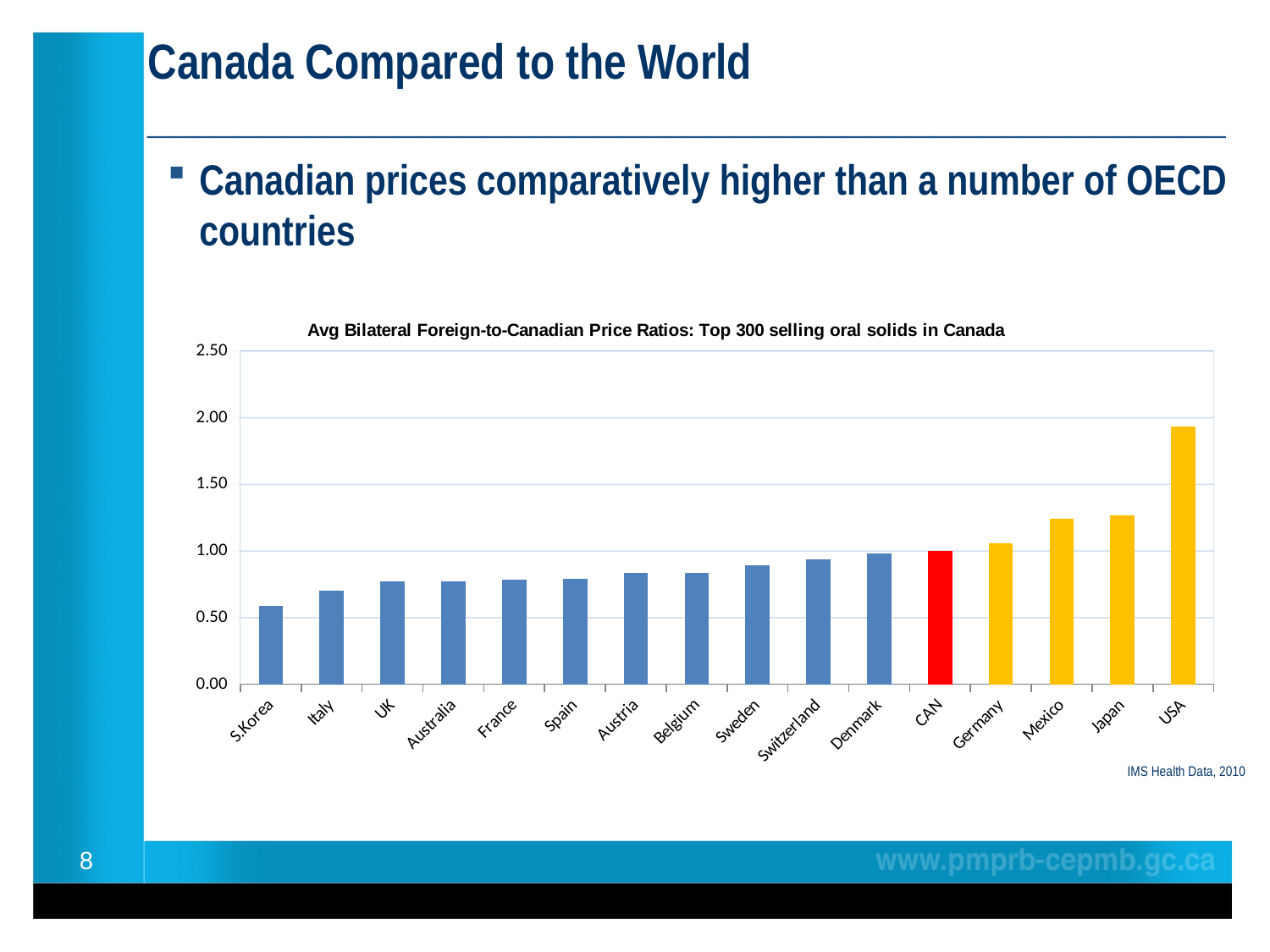
Which has the larger value, USA or Japan? USA Is the value for S.Korea greater or less than 1.00? less Which country has the highest price ratio in the chart? USA What kind of chart is shown on the slide? bar chart Is the value for Italy greater or less than 1.00? less Which country has the lowest price ratio in the chart? S.Korea Do the values generally rise or fall moving from left to right along the x axis? rise Which has the larger value, S.Korea or Italy? Italy Is the value for Mexico greater or less than 1.00? greater How many countries are shown on the x axis of the chart? 16 What is the title of the chart? Avg Bilateral Foreign-to-Canadian Price Ratios: Top 300 selling oral solids in Canada